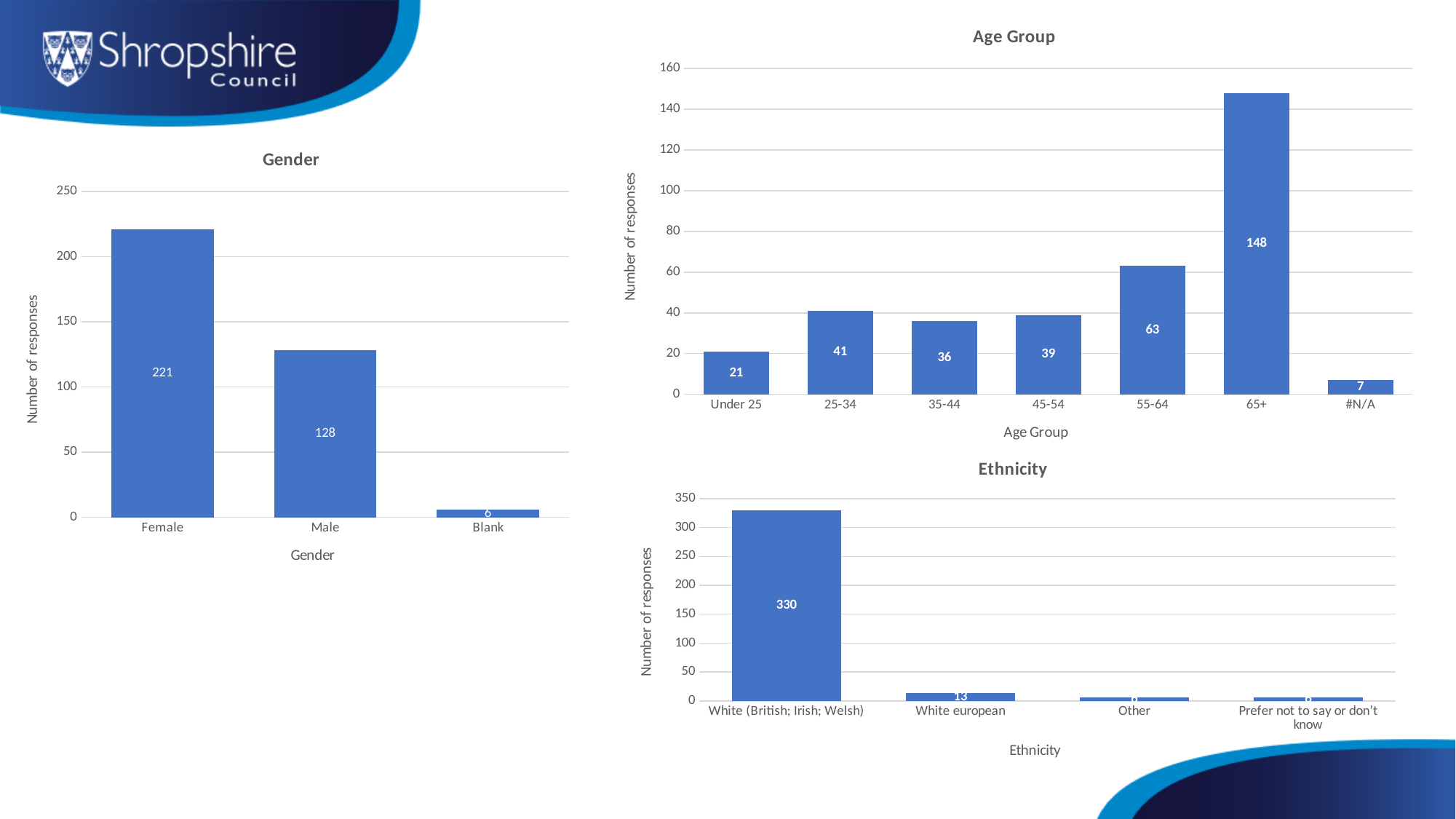
In the Gender chart, how many responses were from Male respondents? 128 What type of chart is the Ethnicity chart? Bar chart In the Age Group chart, which has more responses, 35-44 or 45-54? 45-54 In the Gender chart, what is the difference between the Female and Male response counts? 93 In the Age Group chart, how many categories are shown on the x axis? 7 In the Age Group chart, how many responses were from the 55-64 age group? 63 In the Gender chart, how many responses were from Female respondents? 221 In the Gender chart, how many categories are shown on the x axis? 3 In the Ethnicity chart, is the value for White european greater or less than 50? less In the Age Group chart, how many responses were from the 25-34 age group? 41 In the Ethnicity chart, how many responses were from White (British; Irish; Welsh) respondents? 330 In the Age Group chart, which age group has the highest number of responses? 65+